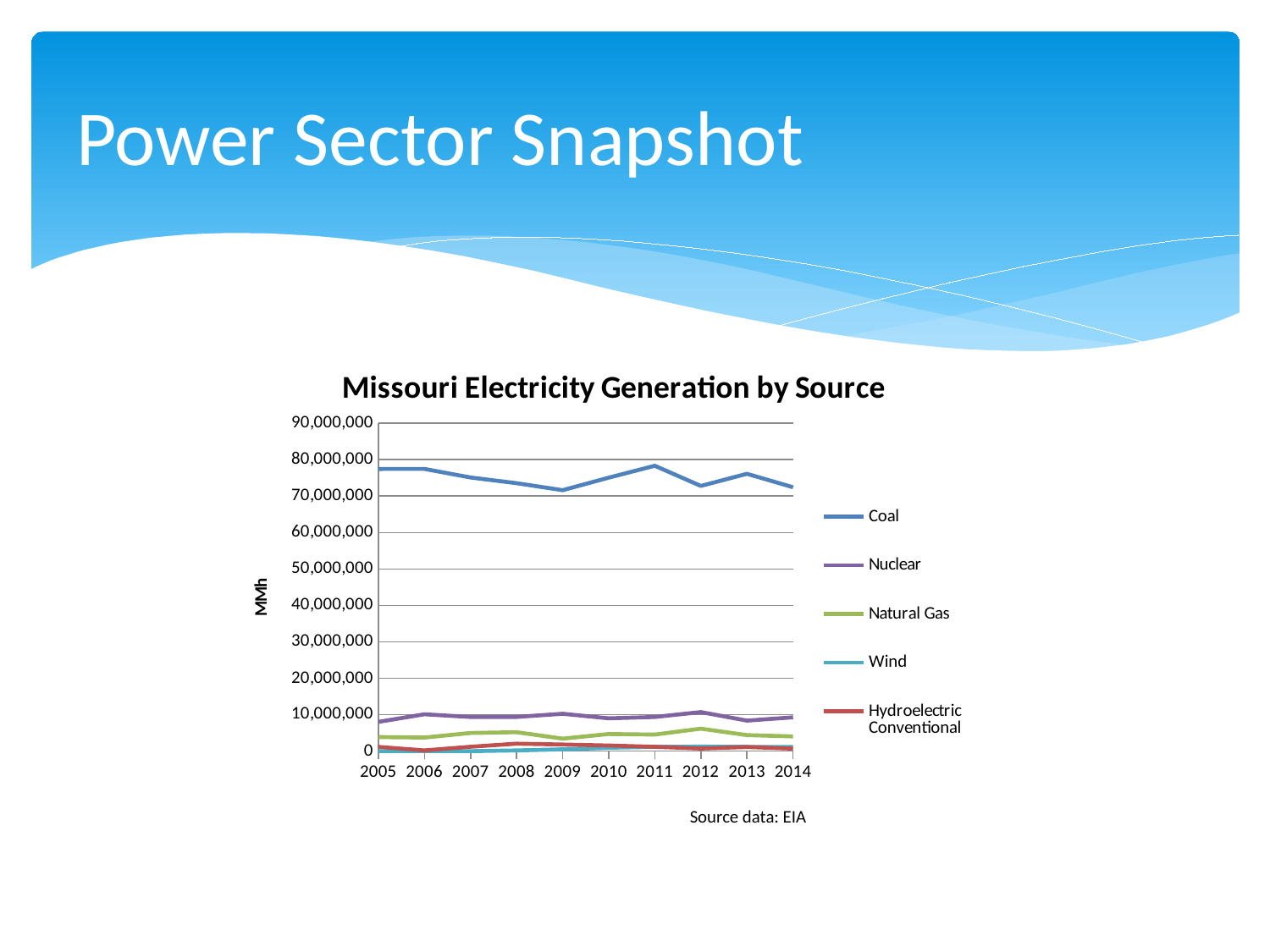
Which is larger in 2010, Coal or Nuclear? Coal Which source has the highest electricity generation across all years? Coal Which is larger in 2009, Nuclear or Natural Gas? Nuclear Is the value for Coal in 2009 greater or less than 80,000,000? less How many series does the legend list? 5 How many years are plotted along the x axis? 10 What is the title of the chart? Missouri Electricity Generation by Source Is the value for Nuclear in 2012 greater or less than 20,000,000? less Does the Coal line rise or fall between 2009 and 2011? rise Is the value for Coal in 2005 greater or less than 70,000,000? greater What kind of chart is shown on the slide? line chart